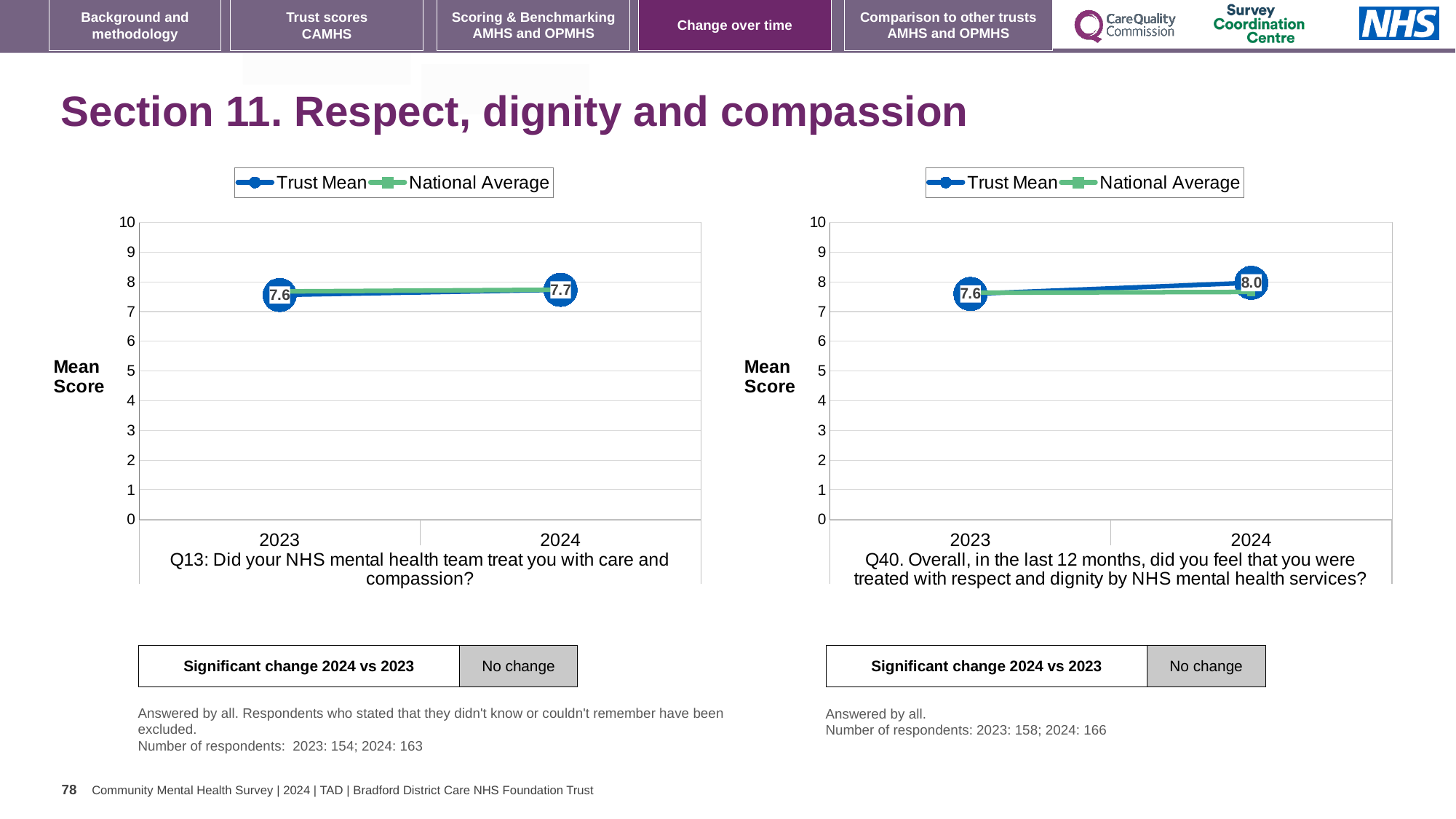
How many series does the legend of the right chart (Q40) list? 2 In the right chart (Q40), is the National Average value for 2024 greater or less than 5? greater What kind of chart is the left chart (Q13)? line chart In the left chart (Q13), by how much did the Trust Mean change from 2023 to 2024? 0.1 How many years are shown on the x axis of the left chart (Q13)? 2 In the right chart (Q40), what is the Trust Mean score for 2024? 8.0 What are the two series named in the legend of the left chart (Q13)? Trust Mean and National Average In the right chart (Q40), by how much did the Trust Mean change from 2023 to 2024? 0.4 In the left chart (Q13), what is the Trust Mean score for 2023? 7.6 In the left chart (Q13), what is the Trust Mean score for 2024? 7.7 In the right chart (Q40), what is the Trust Mean score for 2023? 7.6 In the right chart (Q40), does the Trust Mean rise or fall from 2023 to 2024? rise